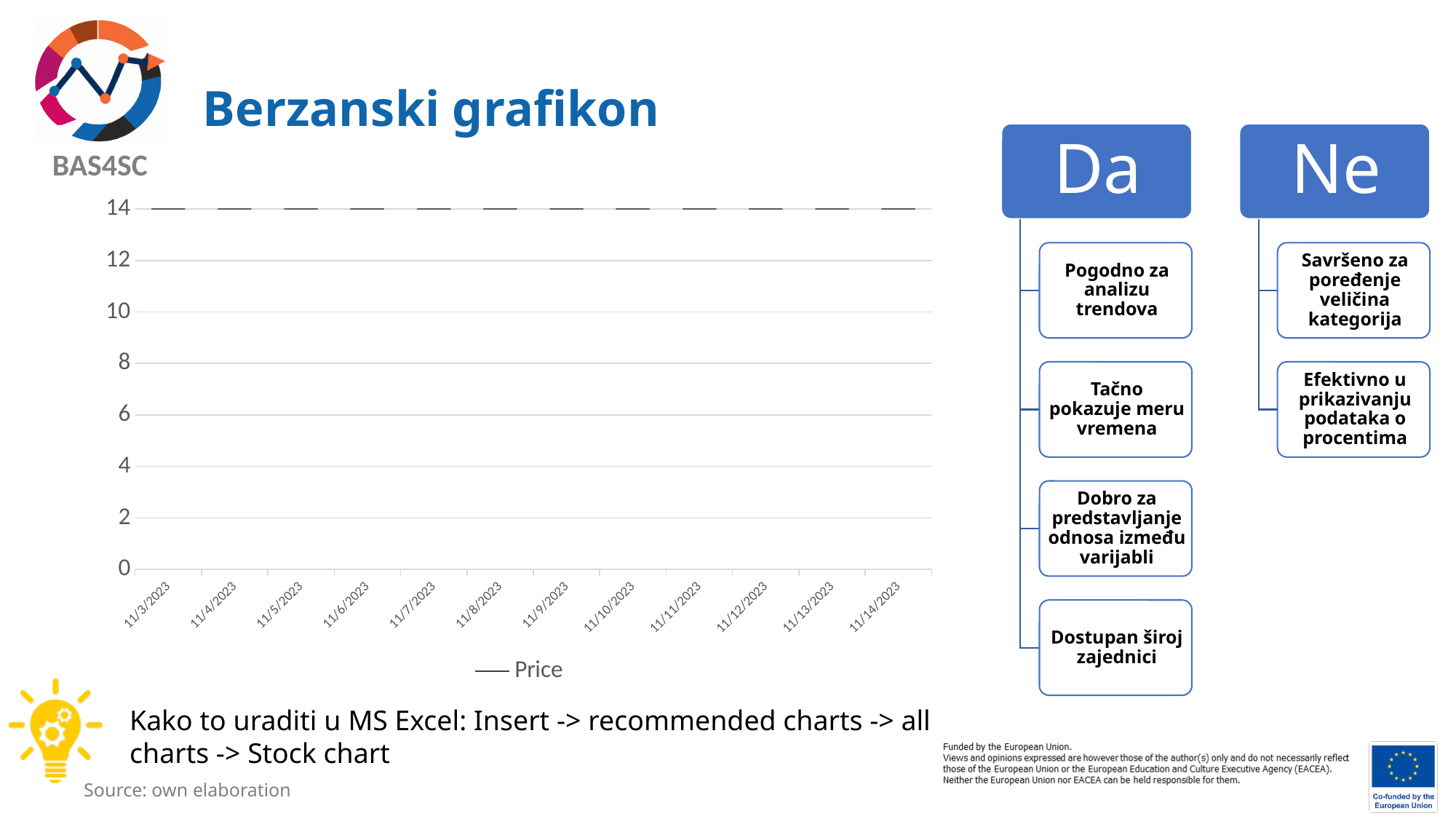
What is the name of the series shown in the chart legend? Price How many dates are shown on the x axis of the chart? 12 Is the value for 11/8/2023 greater or less than 8? greater What is the first date shown on the x axis? 11/3/2023 How many series does the chart legend list? 1 What is the highest value shown on the y axis of the chart? 14 Is the value for 11/14/2023 greater or less than 12? greater What kind of chart is shown on the slide? stock chart Is the value for 11/3/2023 greater or less than 10? greater